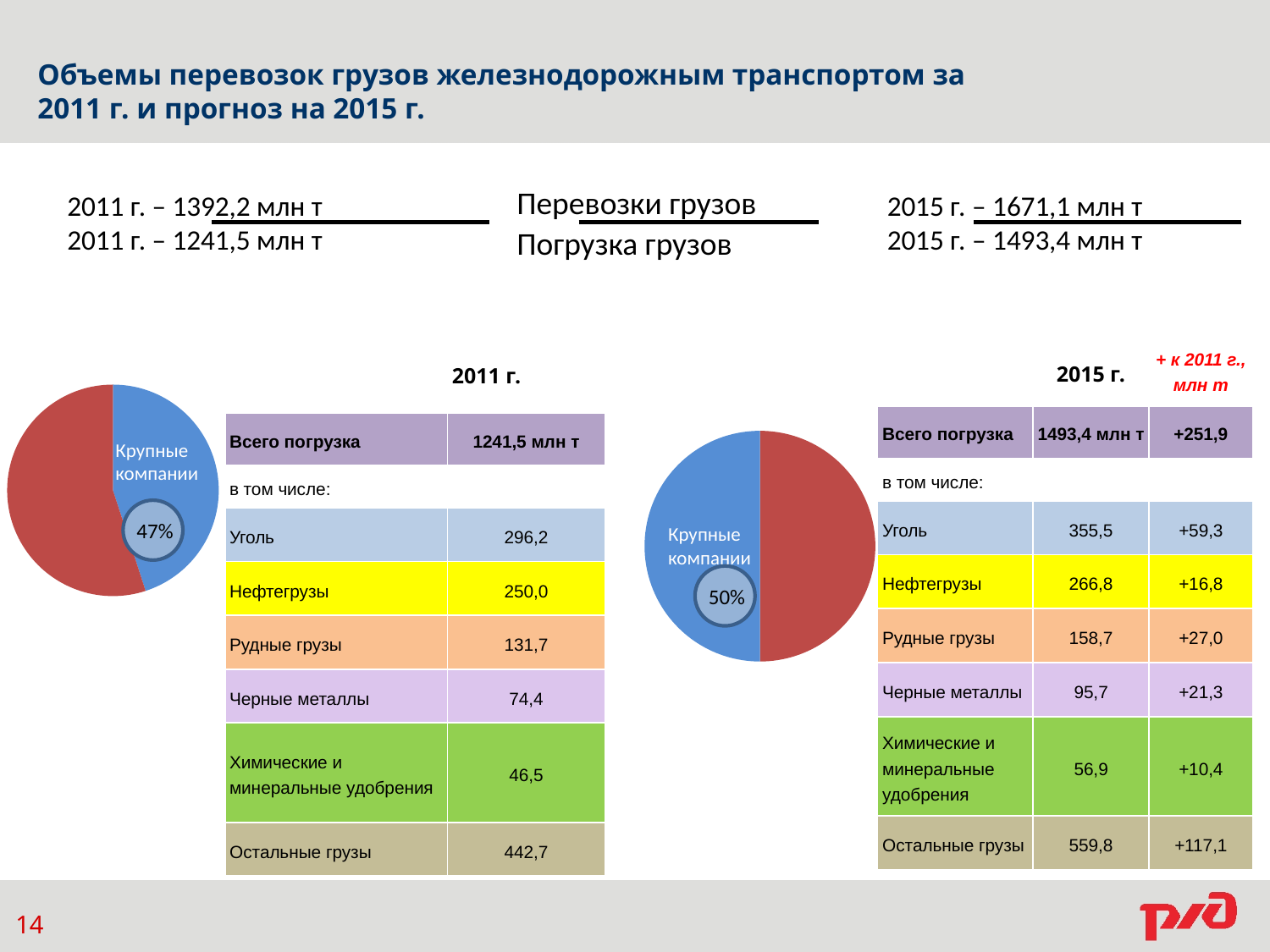
How many pie charts are on the slide? 2 By how many percentage points does the "Крупные компании" share in the 2015 pie chart exceed that in the 2011 pie chart? 3 percentage points In the 2015 pie chart, what share is labelled for "Крупные компании"? 50% How many slices does the 2011 pie chart have? 2 What heading is shown above the left pie chart and its table? 2011 г. In the 2011 pie chart, is the share for "Крупные компании" greater or less than 50%? less What kind of chart is shown on the left side of the slide under "2011 г."? pie chart In the 2011 pie chart, what share is labelled for "Крупные компании"? 47% In the 2011 pie chart, is the "Крупные компании" slice larger or smaller than the other slice? smaller Which pie chart shows the larger share for "Крупные компании", the 2011 one or the 2015 one? 2015 What colour is the "Крупные компании" slice in the pie charts? blue